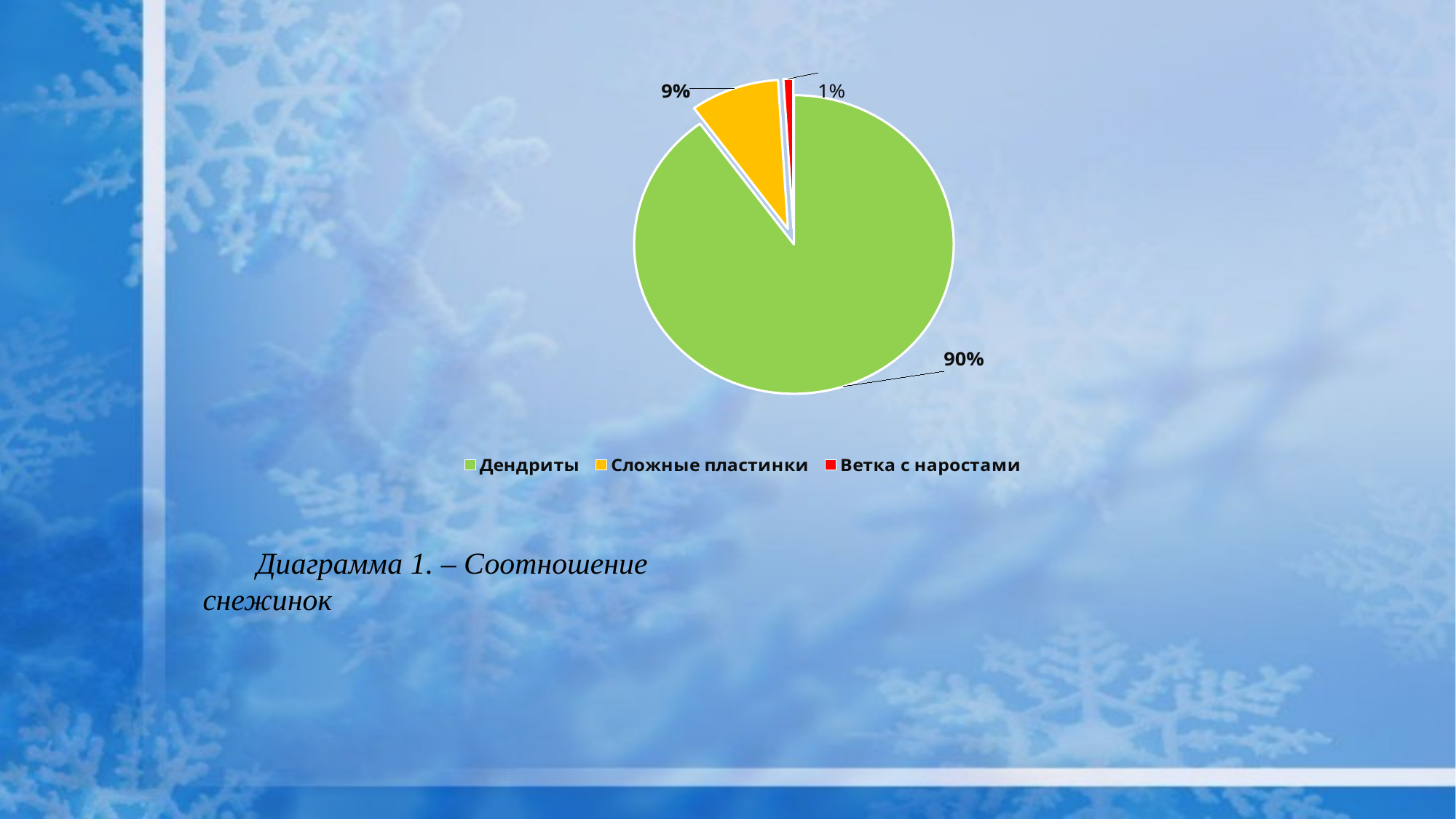
What colour is the slice for Дендриты? green What share of the pie does Сложные пластинки have? 9% What is the difference in percentage points between Сложные пластинки and Ветка с наростами? 8 Which category has the smallest slice of the pie? Ветка с наростами What share of the pie does Ветка с наростами have? 1% How many categories does the pie chart have? 3 Which is larger, the slice for Сложные пластинки or the slice for Ветка с наростами? Сложные пластинки What is the difference in percentage points between Дендриты and Сложные пластинки? 81 What share of the pie does Дендриты have? 90% What kind of chart is shown on the slide? pie chart What is the caption below the chart? Диаграмма 1. – Соотношение снежинок Which category has the largest slice of the pie? Дендриты